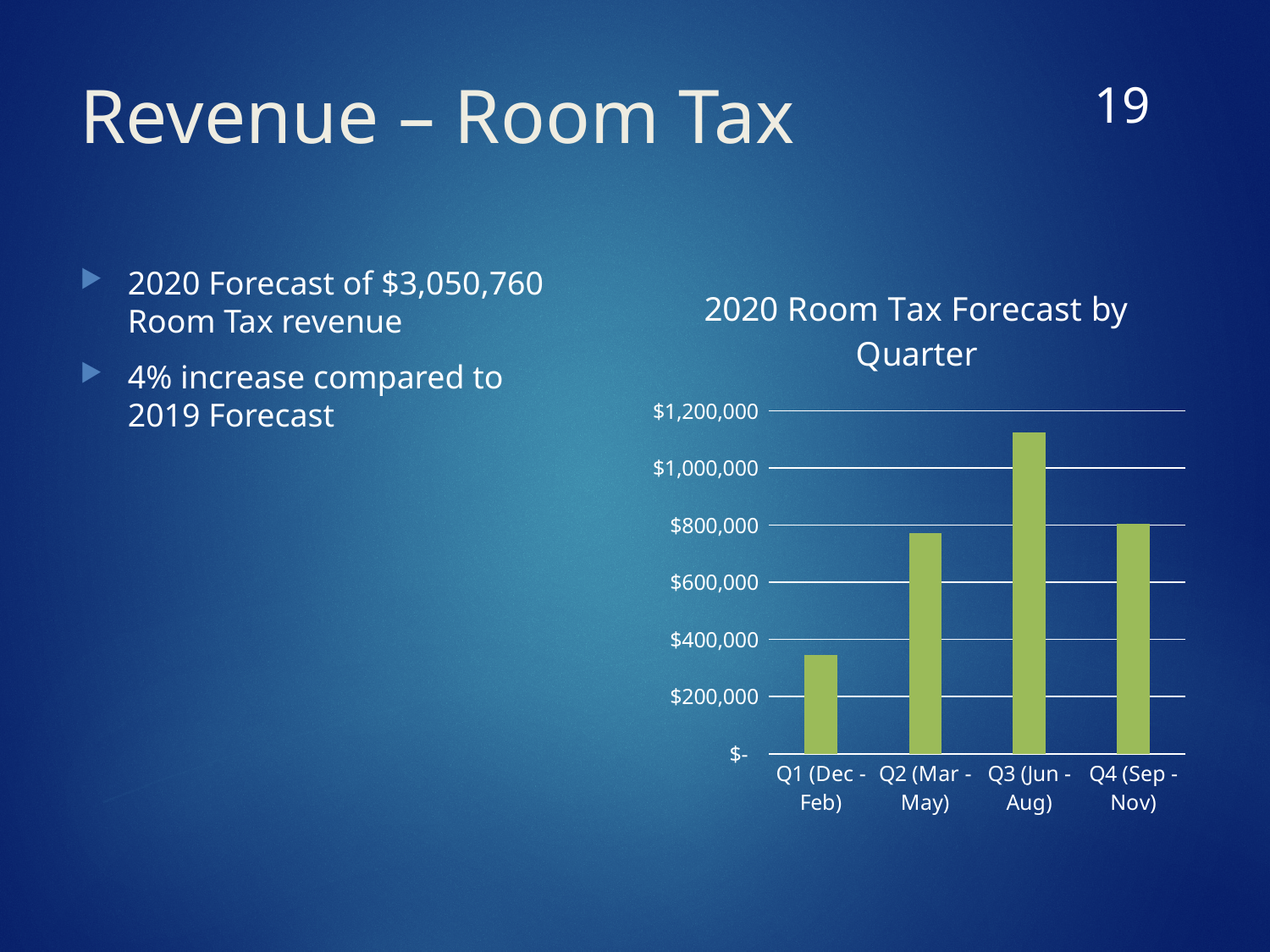
Which quarter has the highest forecast room tax? Q3 (Jun - Aug) Which is larger, the value for Q2 (Mar - May) or Q1 (Dec - Feb)? Q2 (Mar - May) Is the value for Q4 (Sep - Nov) greater or less than $600,000? greater Is the value for Q1 (Dec - Feb) greater or less than $400,000? less What is the title of the chart? 2020 Room Tax Forecast by Quarter Is the value for Q1 (Dec - Feb) greater or less than $200,000? greater Which quarter has the lowest forecast room tax? Q1 (Dec - Feb) What type of chart is shown on the slide? Bar chart How many quarters are plotted in the chart? 4 Which is larger, the value for Q3 (Jun - Aug) or Q1 (Dec - Feb)? Q3 (Jun - Aug)